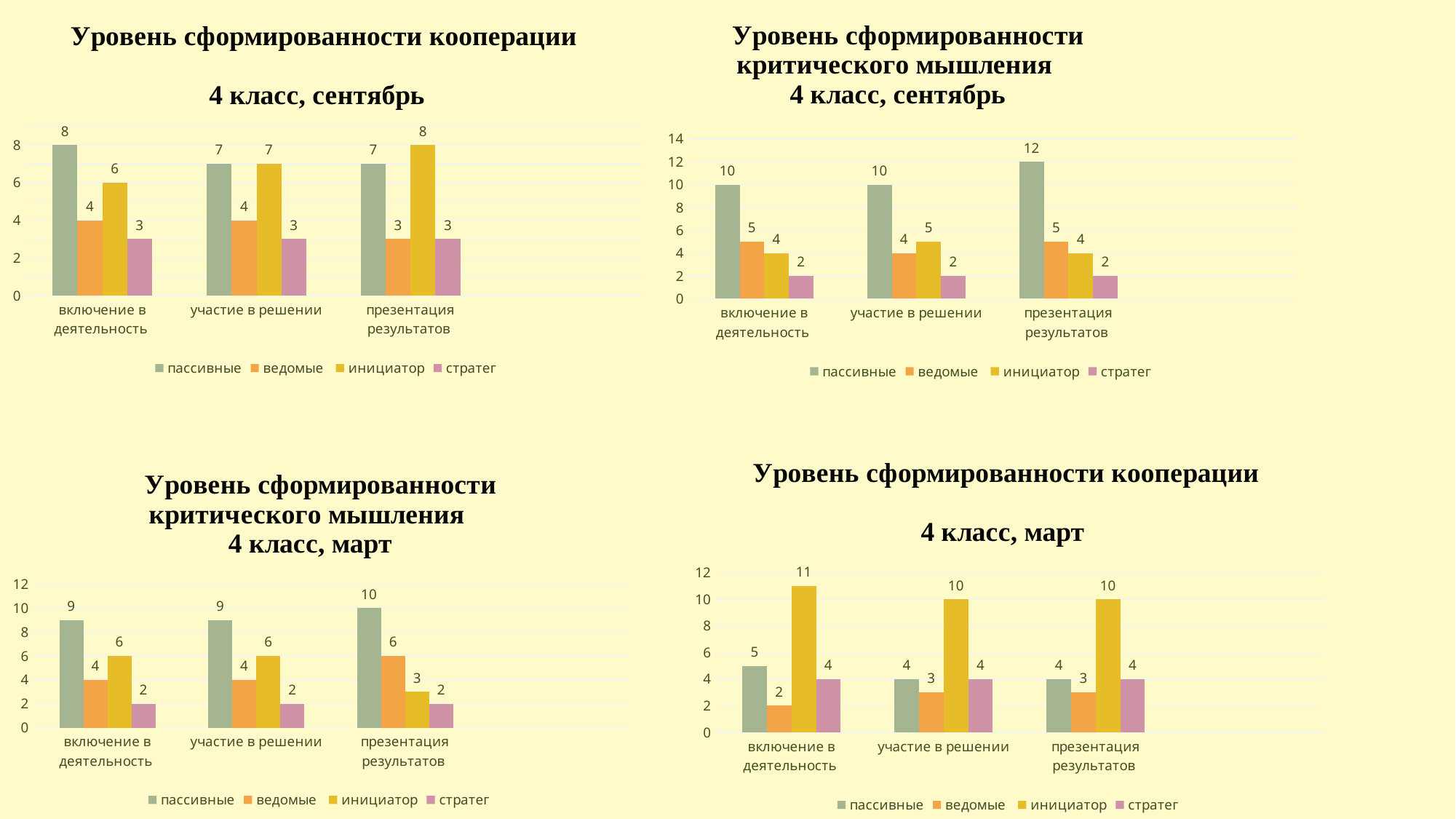
How many series does the legend of the top-left chart (Уровень сформированности кооперации, 4 класс, сентябрь) list? 4 In the top-left chart (Уровень сформированности кооперации, 4 класс, сентябрь), what is the value for инициатор in the category презентация результатов? 8 In the top-right chart (Уровень сформированности критического мышления, 4 класс, сентябрь), what is the value for стратег in the category участие в решении? 2 In the top-left chart (Уровень сформированности кооперации, 4 класс, сентябрь), what is the value for пассивные in the category включение в деятельность? 8 In the top-right chart (Уровень сформированности критического мышления, 4 класс, сентябрь), which category has the highest value for пассивные? презентация результатов What type of chart is the bottom-left chart (Уровень сформированности критического мышления, 4 класс, март)? bar chart In the bottom-right chart (Уровень сформированности кооперации, 4 класс, март), which is larger in the category участие в решении: пассивные or инициатор? инициатор In the bottom-right chart (Уровень сформированности кооперации, 4 класс, март), what is the difference between инициатор and ведомые in the category включение в деятельность? 9 How many categories are shown on the x axis of the top-right chart (Уровень сформированности критического мышления, 4 класс, сентябрь)? 3 In the bottom-right chart (Уровень сформированности кооперации, 4 класс, март), what is the value for инициатор in the category включение в деятельность? 11 In the bottom-left chart (Уровень сформированности критического мышления, 4 класс, март), what is the difference between пассивные and ведомые in the category презентация результатов? 4 In the bottom-left chart (Уровень сформированности критического мышления, 4 класс, март), which series has the lowest value in the category включение в деятельность? стратег